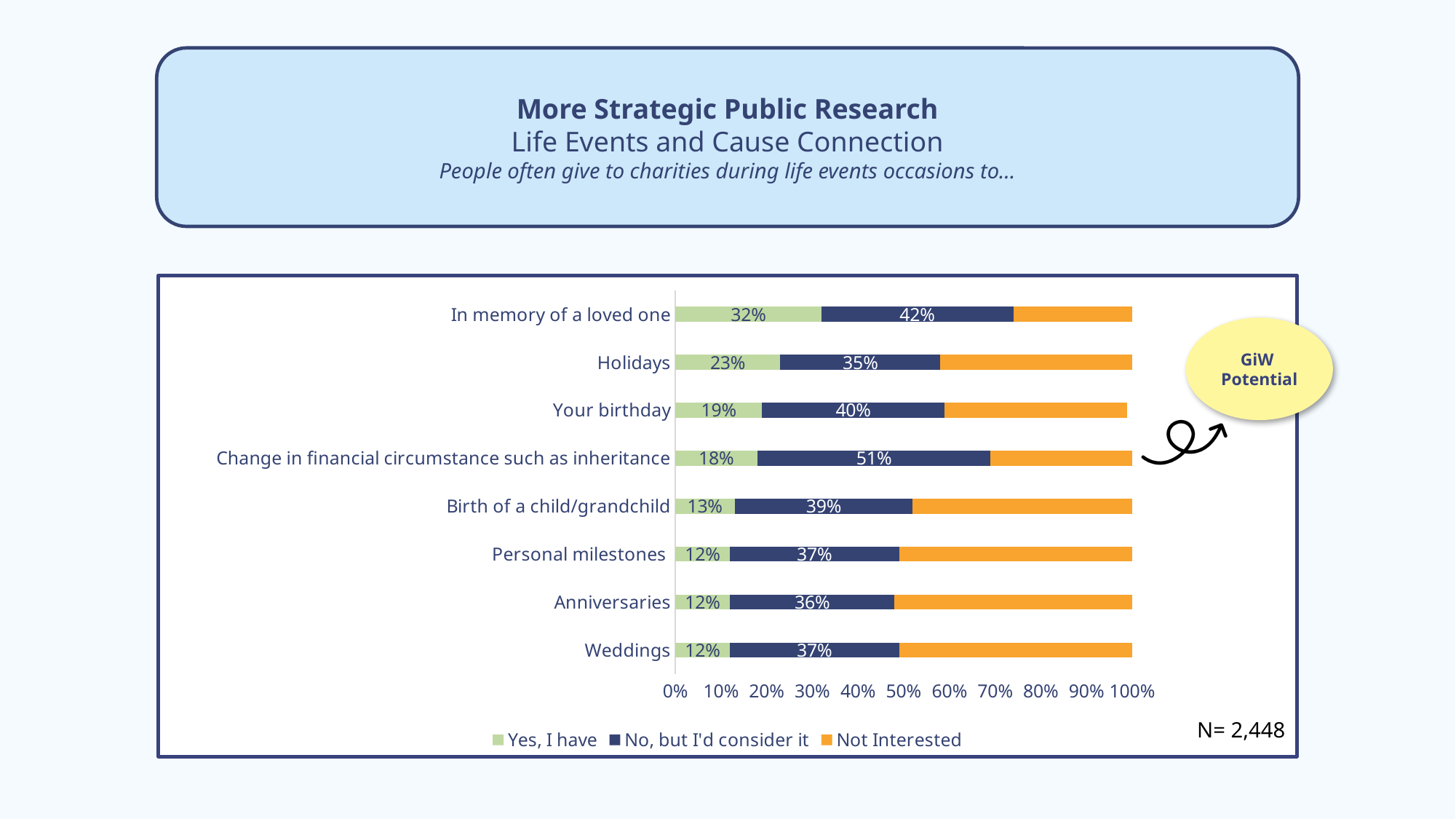
What percentage answered "Yes, I have" for In memory of a loved one? 32% How many life events are listed in the chart? 8 Which has a higher "Yes, I have" value, Holidays or Your birthday? Holidays For In memory of a loved one, how many percentage points higher is "No, but I'd consider it" than "Yes, I have"? 10 percentage points Is the "Not Interested" value for In memory of a loved one greater or less than 30%? less What percentage answered "No, but I'd consider it" for Change in financial circumstance such as inheritance? 51% What is the "No, but I'd consider it" value for Birth of a child/grandchild? 39% How many series does the legend list? 3 What kind of chart is shown on the slide? Stacked bar chart Which life event has the highest "No, but I'd consider it" percentage? Change in financial circumstance such as inheritance What is the "Yes, I have" value for Holidays? 23% Which life event has the highest "Yes, I have" percentage? In memory of a loved one